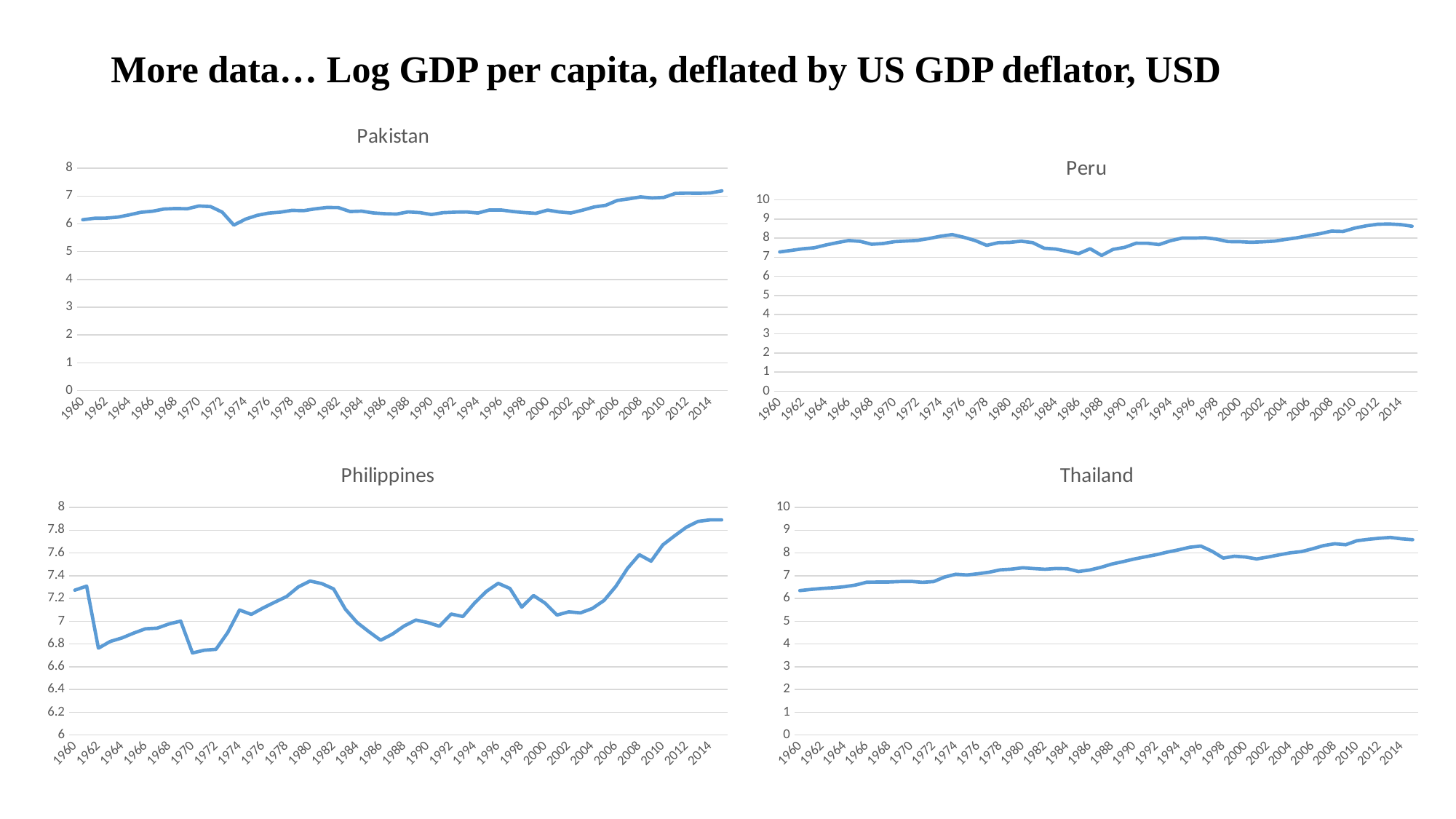
In the Pakistan chart, do the values generally rise or fall from 1960 to 2014? rise What is the title of the chart in the bottom-left of the slide? Philippines What is the title of the chart in the top-right of the slide? Peru In the Pakistan chart, is the value for 1960 greater or less than 7? less In the Thailand chart, do the values generally rise or fall from 1960 to 2014? rise In the Peru chart, is the value for 1988 greater or less than 8? less What kind of chart is the Pakistan chart? line chart In the Peru chart, is the value for 2012 greater or less than 8? greater How many charts are shown on the slide? 4